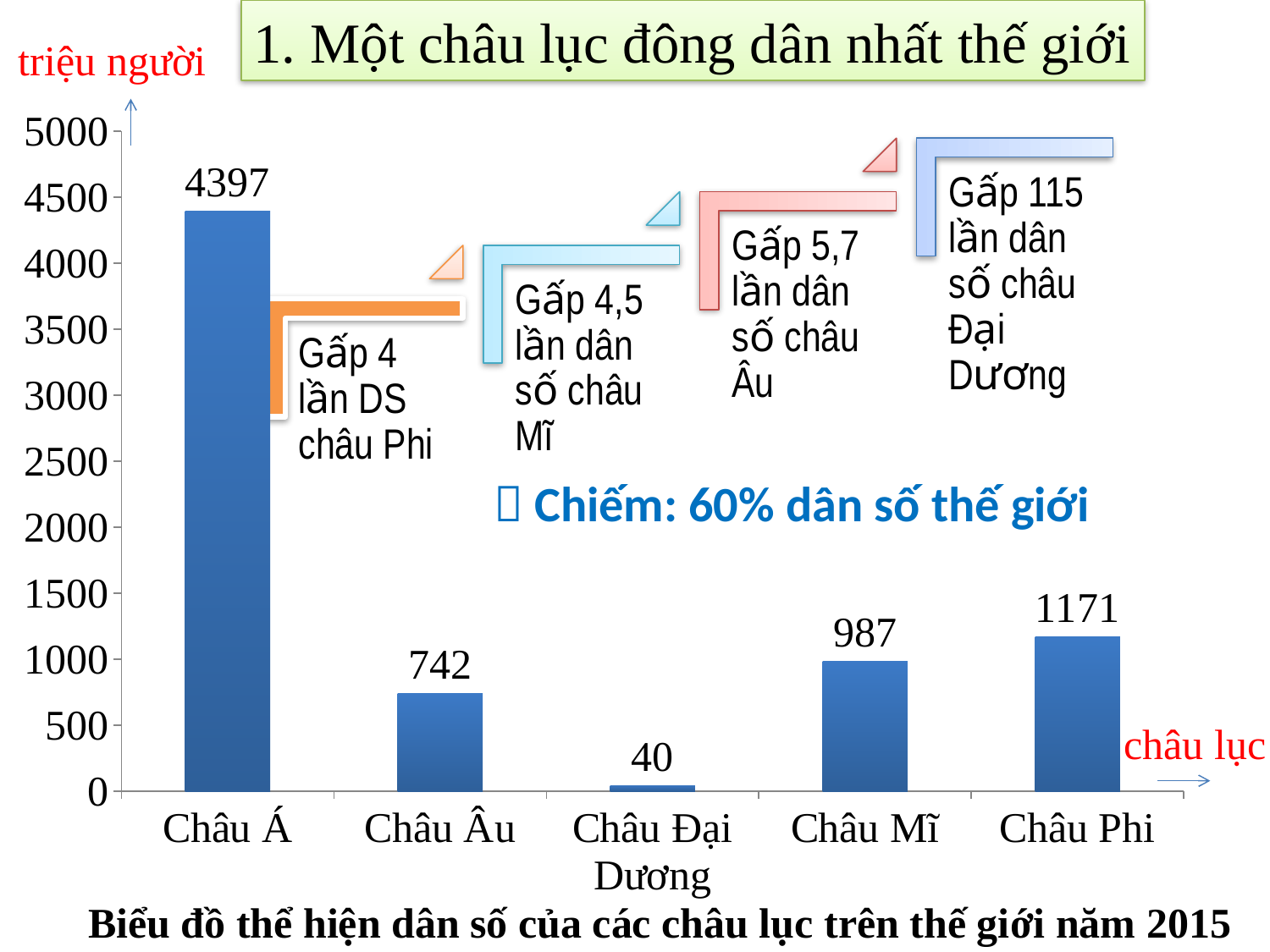
What is the population value shown for Châu Phi? 1171 Which continent has the highest bar in the chart? Châu Á How many continents (categories) are shown on the x axis? 5 Which is larger, the value for Châu Mĩ or the value for Châu Âu? Châu Mĩ What is the difference between the values for Châu Phi and Châu Mĩ? 184 Is the value for Châu Phi greater or less than 1000? greater What is the population value shown for Châu Á? 4397 What is the population value shown for Châu Âu? 742 What is the population value shown for Châu Đại Dương? 40 Which continent has the lowest bar in the chart? Châu Đại Dương What kind of chart is shown on the slide? bar chart What unit is labelled on the vertical axis of the chart? triệu người